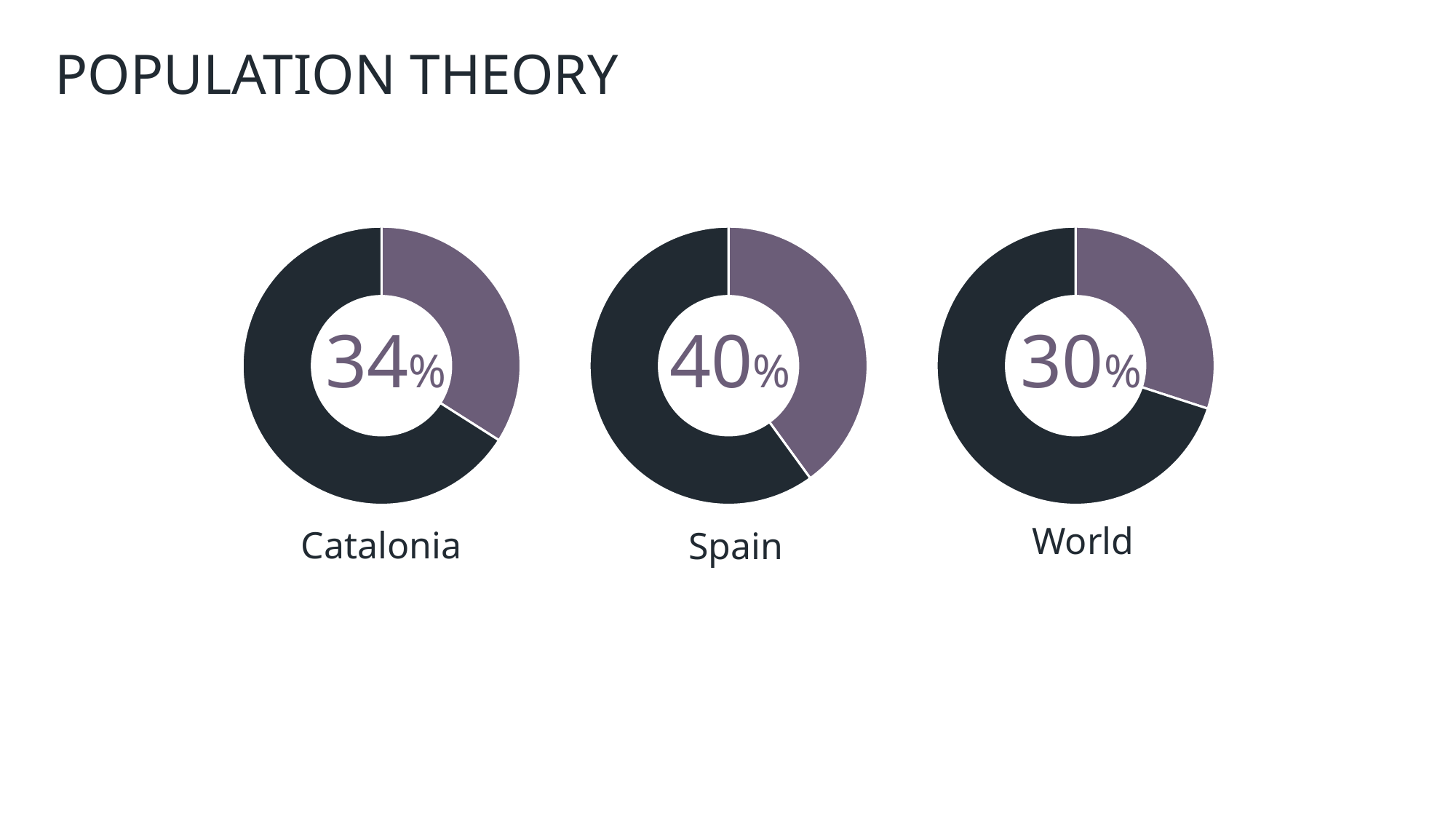
Is the percentage shown for Spain larger or smaller than the percentage shown for Catalonia? larger What is the title of the slide containing the three donut charts? POPULATION THEORY What percentage is shown in the centre of the Spain donut chart? 40% What is the difference between the percentage shown for Catalonia and the percentage shown for World? 4% What percentage is shown in the centre of the World donut chart? 30% How many donut charts are shown on the slide? 3 Is the percentage shown for Catalonia larger or smaller than the percentage shown for World? larger Which of the three donut charts (Catalonia, Spain, World) shows the highest percentage? Spain What percentage is shown in the centre of the Catalonia donut chart? 34% What kind of chart is used to show the Catalonia, Spain and World values? Donut (pie) chart What is the difference between the percentage shown for Spain and the percentage shown for Catalonia? 6% Which of the three donut charts (Catalonia, Spain, World) shows the lowest percentage? World